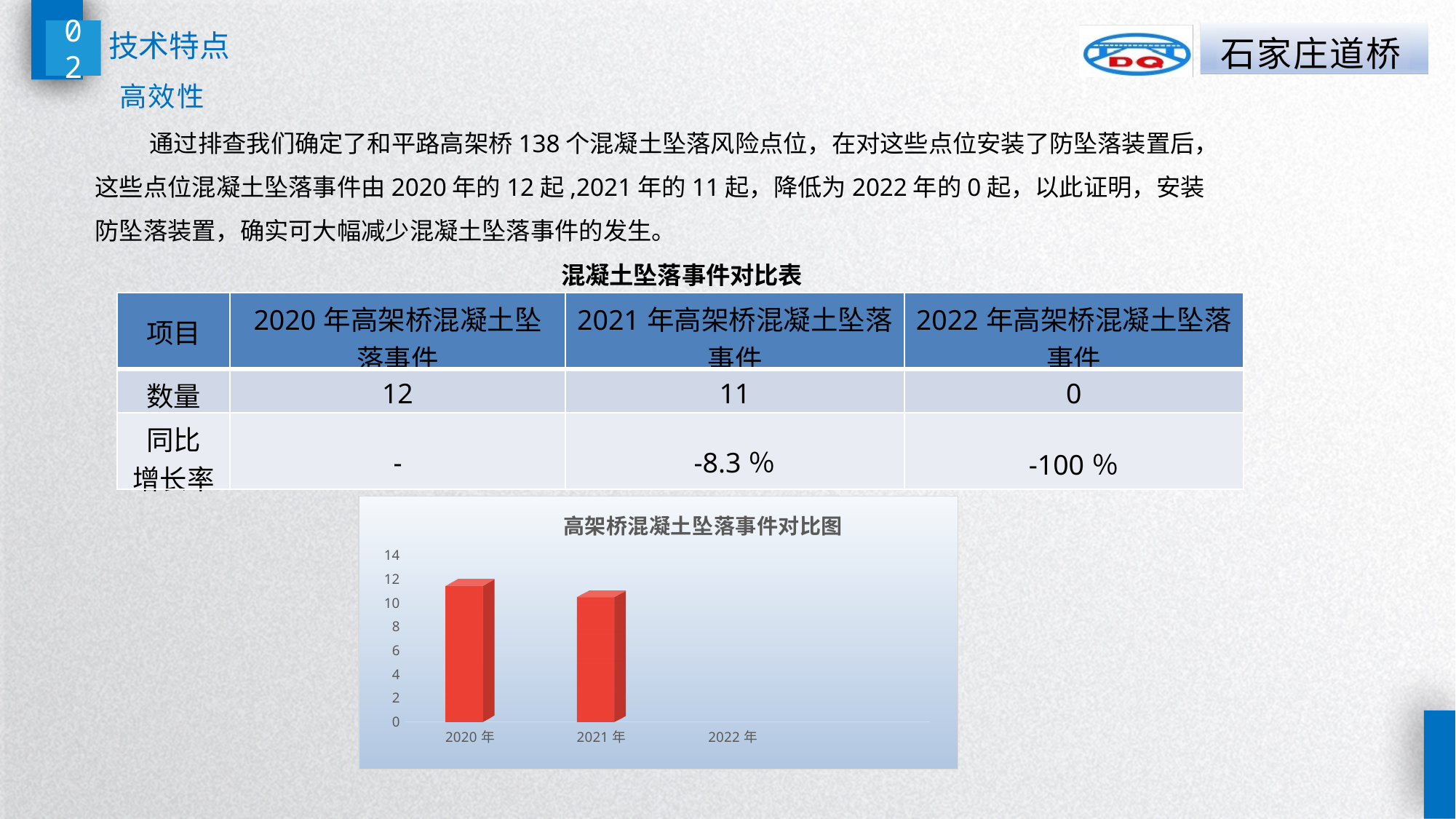
Which year has the lowest value in the chart? 2022 年 Which year has the highest bar in the chart? 2020 年 How many categories are shown on the x axis of the chart? 3 Is the value for 2020 年 greater or less than 8? greater What is the difference between the values for 2020 年 and 2021 年? 1 Is the value for 2021 年 greater or less than 10? greater Do the values rise or fall from 2020 年 to 2022 年 along the x axis? fall What is the value for 2020 年 in the chart? 12 What is the value for 2022 年 in the chart? 0 Which is larger, the value for 2020 年 or the value for 2022 年? 2020 年 What is the title of the chart? 高架桥混凝土坠落事件对比图 What kind of chart is shown on the slide? bar chart